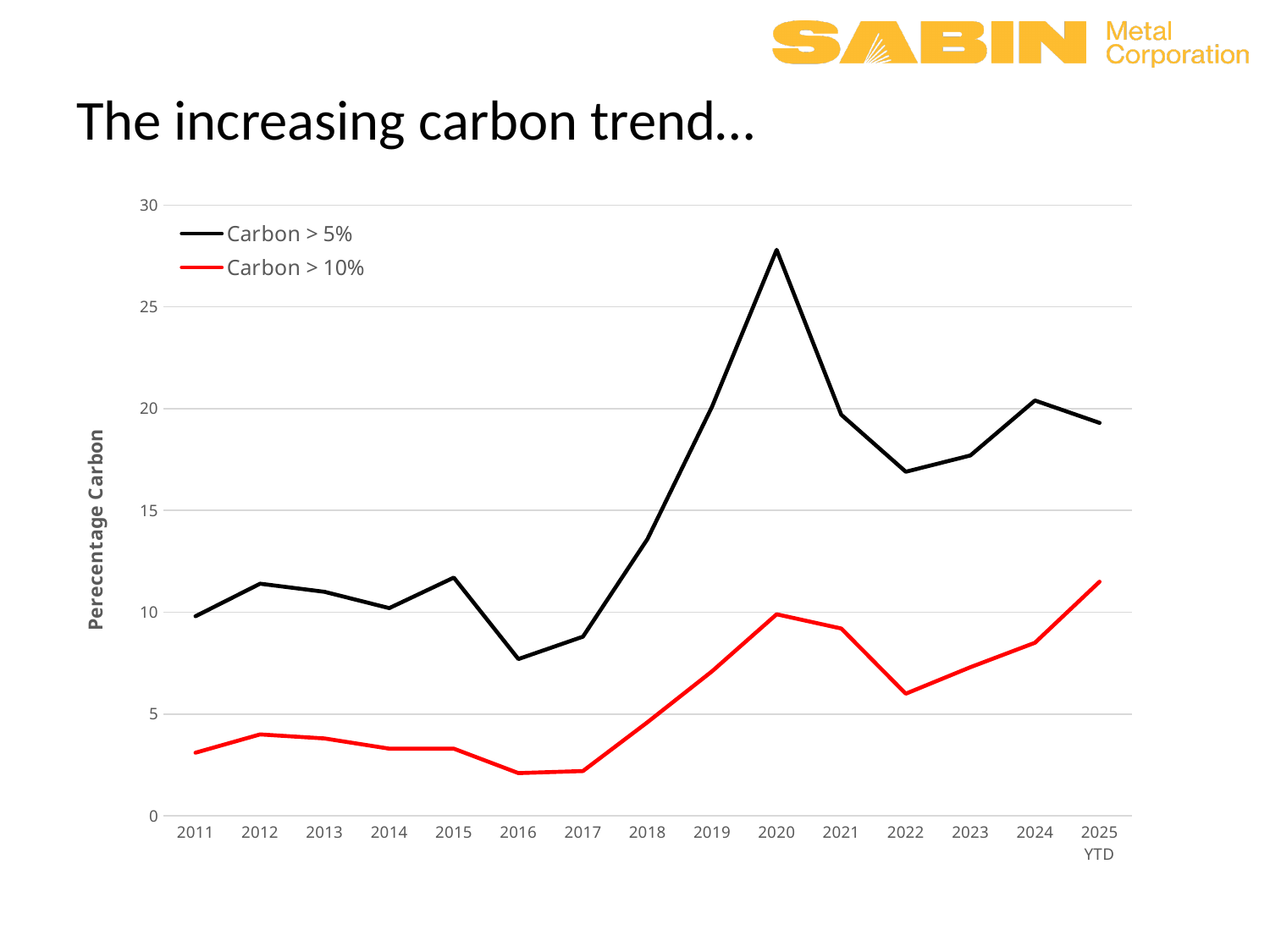
What kind of chart is shown on the slide? line chart Is the value for Carbon > 5% in 2016 greater or less than 10? less Is the value for Carbon > 5% in 2020 greater or less than 25? greater Does the Carbon > 5% series rise or fall from 2017 to 2020? rise How many years (points) are plotted along the x axis? 15 Which is larger for the Carbon > 10% series: the value in 2012 or the value in 2016? 2012 What colour is the line for the Carbon > 10% series? red In which year does the Carbon > 5% series reach its highest value? 2020 Is the value for Carbon > 10% in 2025 YTD greater or less than 10? greater In which year does the Carbon > 5% series reach its lowest value? 2016 How many series does the legend list? 2 In which year does the Carbon > 10% series reach its highest value? 2025 YTD